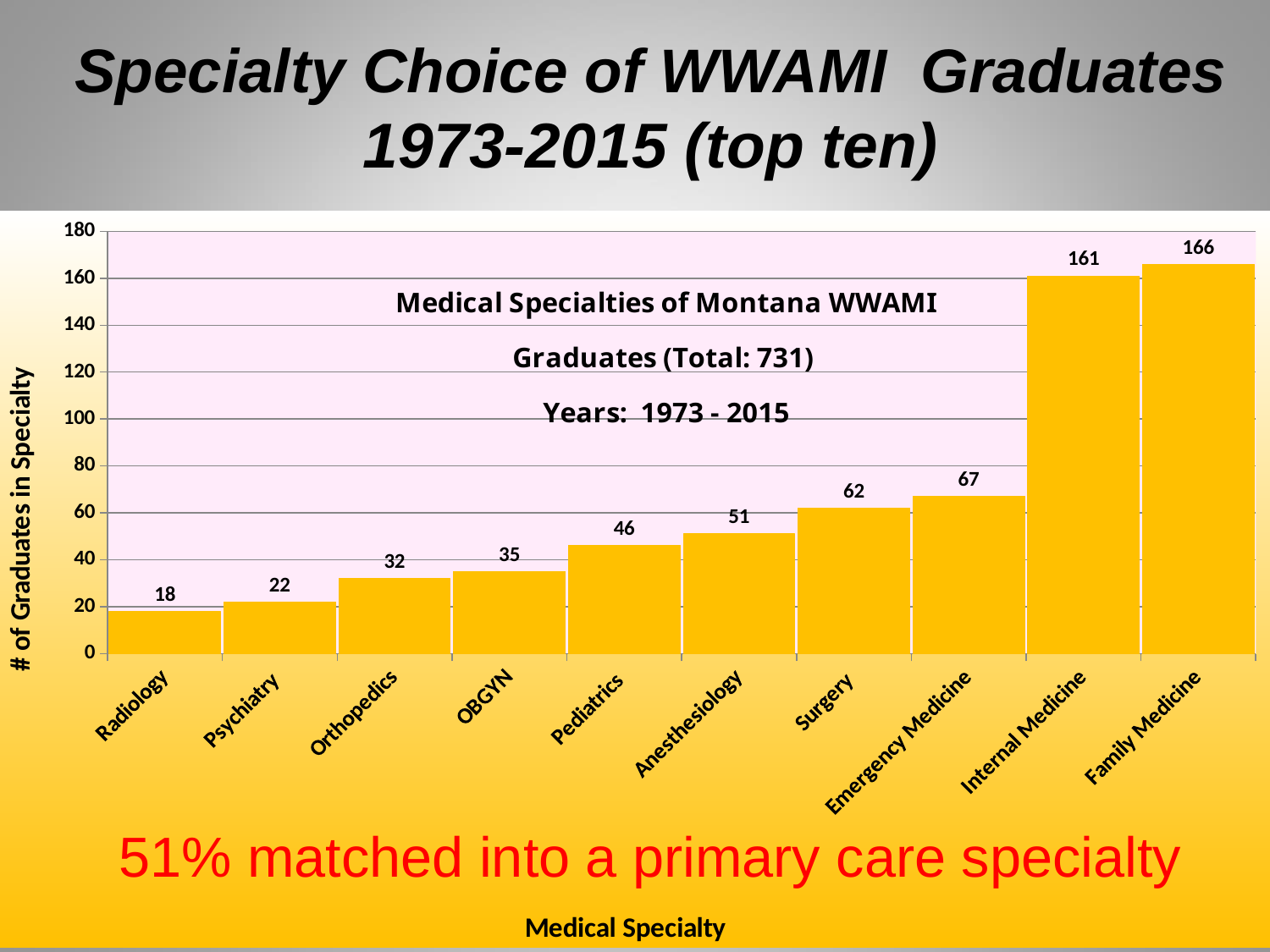
How many graduates are in Internal Medicine? 161 Which has more graduates, Orthopedics or OBGYN? OBGYN What kind of chart is shown? bar chart How many specialties are shown on the x axis? 10 Which specialty has the highest number of graduates? Family Medicine Is the value for Psychiatry greater or less than 40? less What is the value for Emergency Medicine? 67 Which specialty has the lowest number of graduates? Radiology What is the value for Pediatrics? 46 What is the difference between Family Medicine and Internal Medicine? 5 What is the difference between Surgery and Anesthesiology? 11 What is the label of the y axis? # of Graduates in Specialty